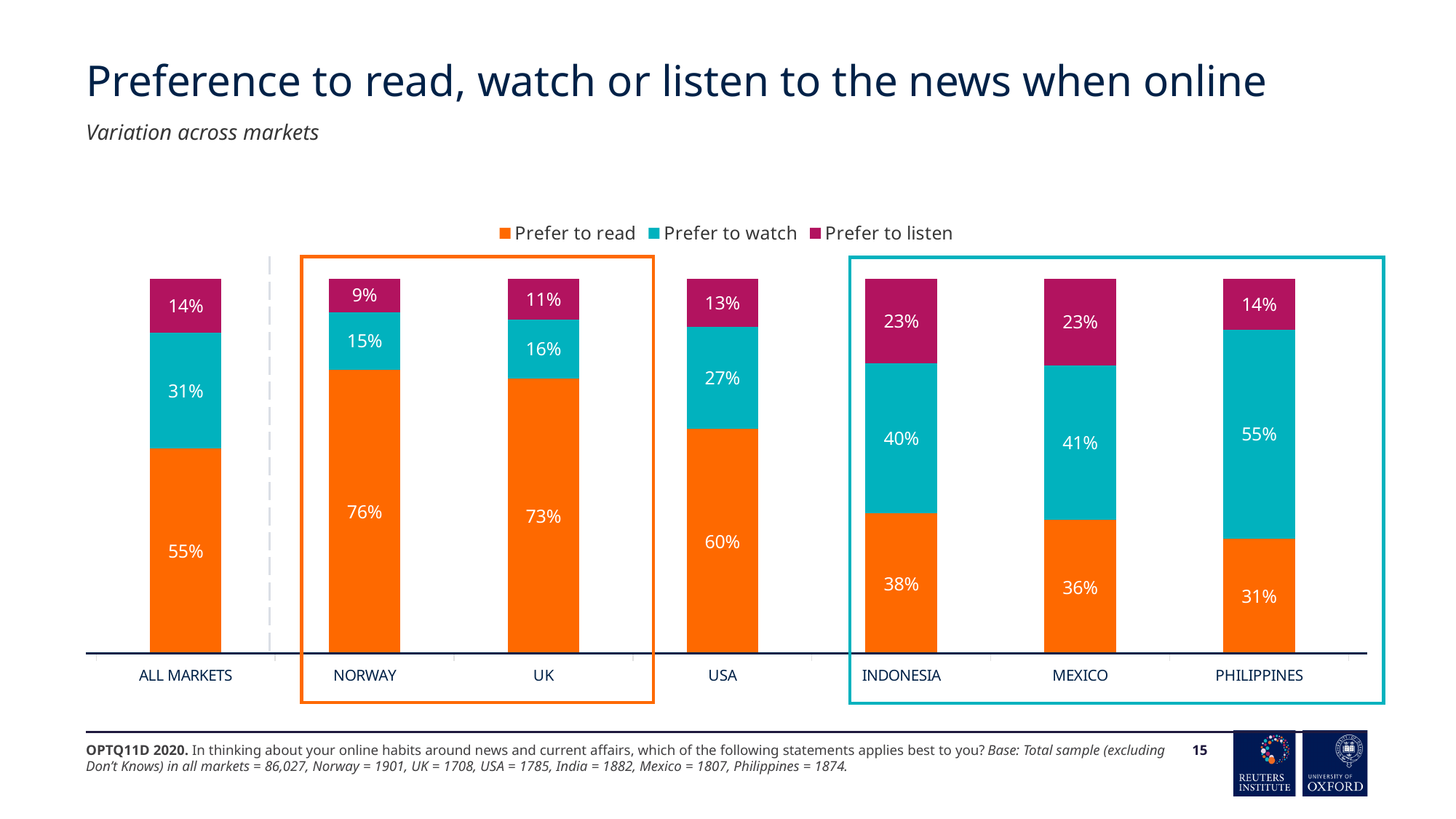
What percentage of respondents in Norway prefer to read the news? 76% What kind of chart is shown on the slide? Stacked bar chart Which colour represents 'Prefer to listen' in the legend? Magenta How many series does the legend list? 3 Which market has the highest 'Prefer to read' value? Norway What is the total of the stacked bar for All Markets? 100% Which has a larger 'Prefer to watch' value, Indonesia or Mexico? Mexico Which market has the lowest 'Prefer to listen' value? Norway What is the 'Prefer to listen' value for Indonesia? 23% How many markets are shown on the x axis? 7 What is the 'Prefer to watch' value for the Philippines? 55% What is the difference between the 'Prefer to read' values for the UK and the USA? 13%